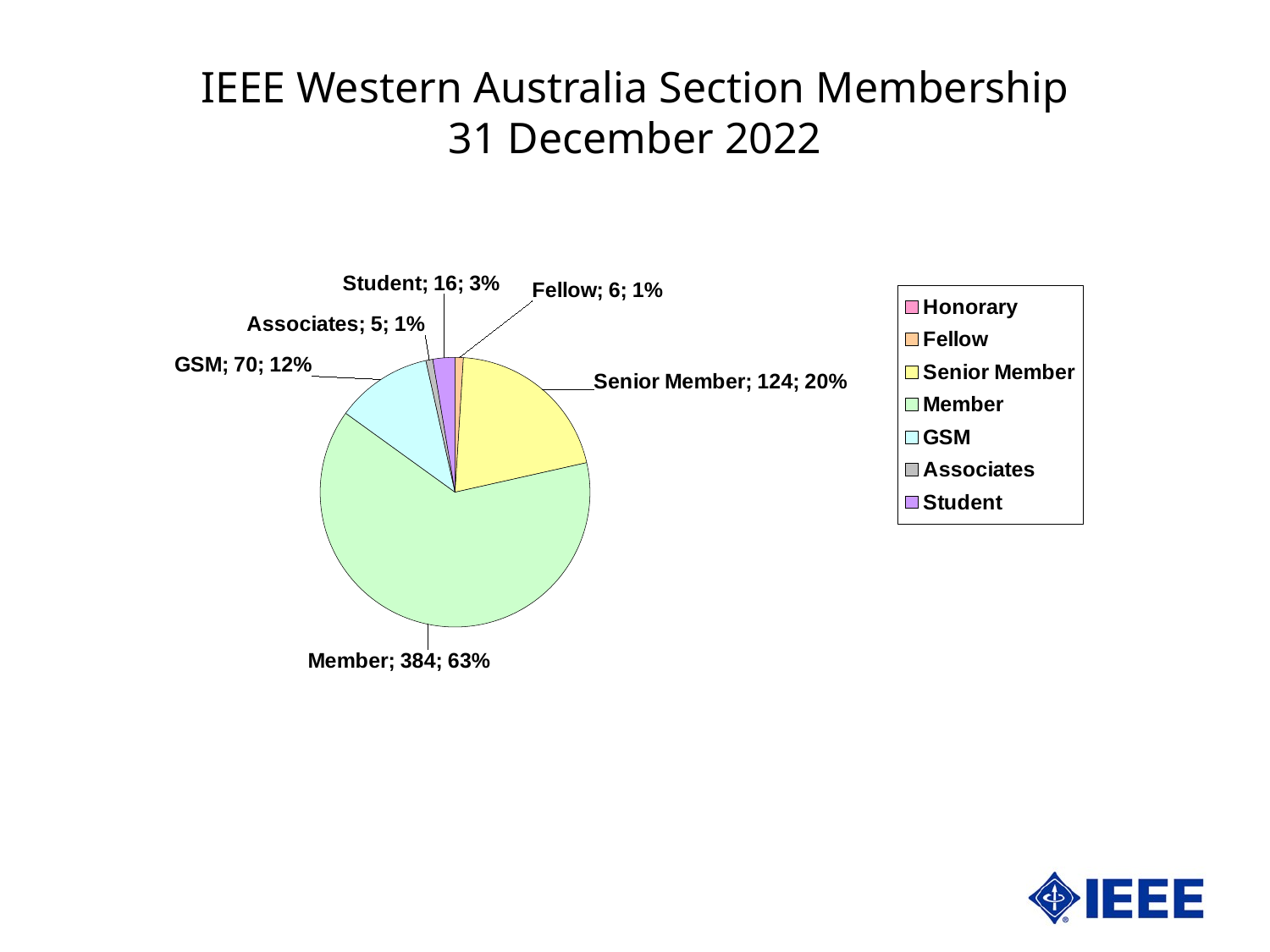
What percentage of the pie does the Student slice represent? 3% Which is larger, the Fellow count or the Student count? Student Which labelled category has the smallest value in the pie chart? Associates What is the value for GSM? 70 What is the difference between the Senior Member count and the GSM count? 54 Which category has the largest slice of the pie? Member What share of the pie does the Member slice take? 63% What kind of chart is shown on the slide? pie chart How many Senior Members are shown in the pie chart? 124 How many entries does the legend list? 7 What colour is the Senior Member slice? yellow How many members are in the Member category? 384